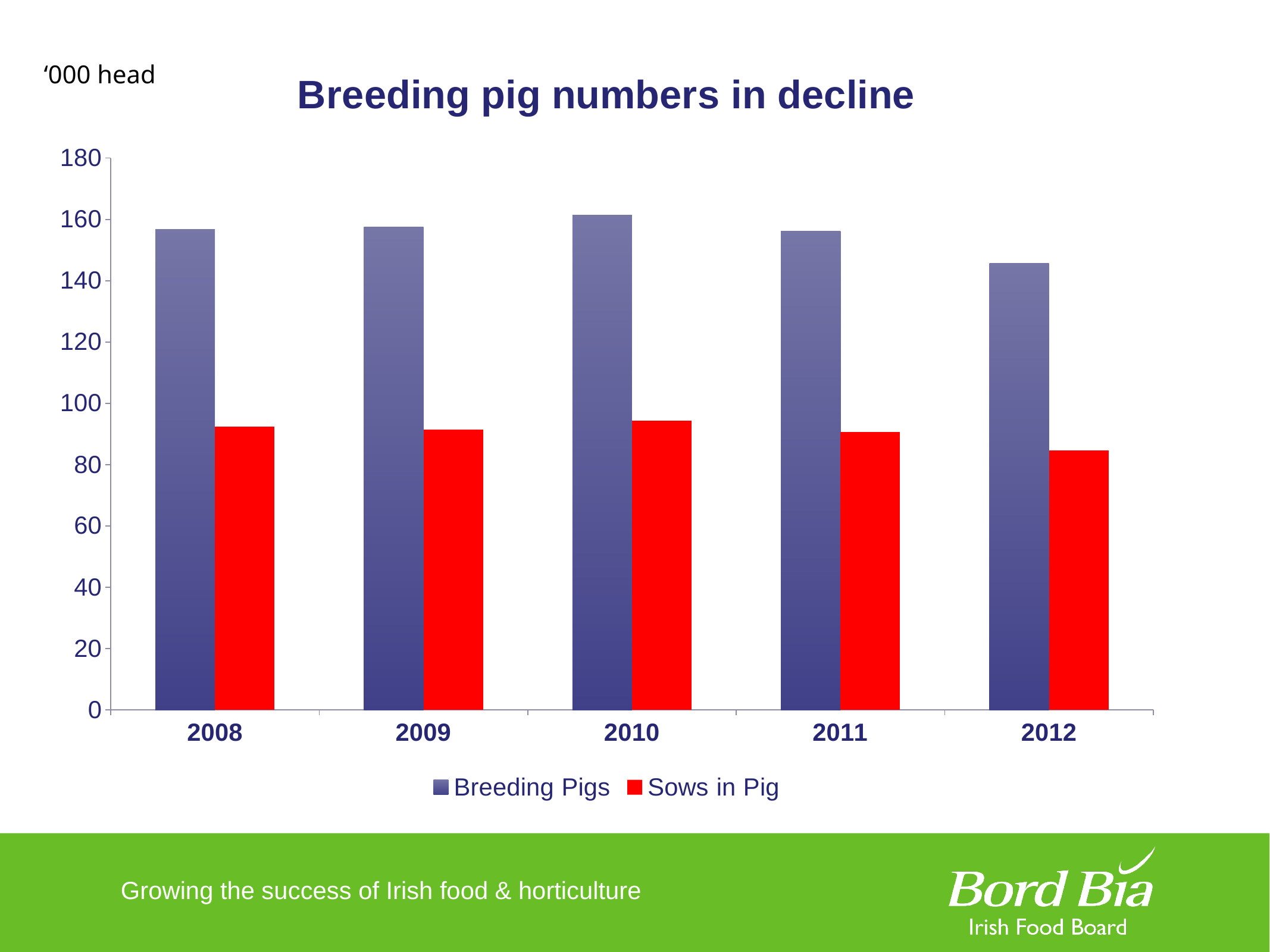
What unit is indicated for the values on the chart? '000 head What kind of chart is shown on the slide? bar chart What is the title of the chart? Breeding pig numbers in decline Is the Sows in Pig value for 2012 greater or less than 100? less How many series does the chart legend list? 2 In which year is the Breeding Pigs value lowest? 2012 Do the Breeding Pigs values rise or fall from 2010 to 2012? fall Is the Breeding Pigs value for 2012 greater or less than 140? greater In which year is the Sows in Pig value lowest? 2012 In which year is the Breeding Pigs value highest? 2010 How many years are shown on the x axis of the chart? 5 Which is larger in 2012, Breeding Pigs or Sows in Pig? Breeding Pigs